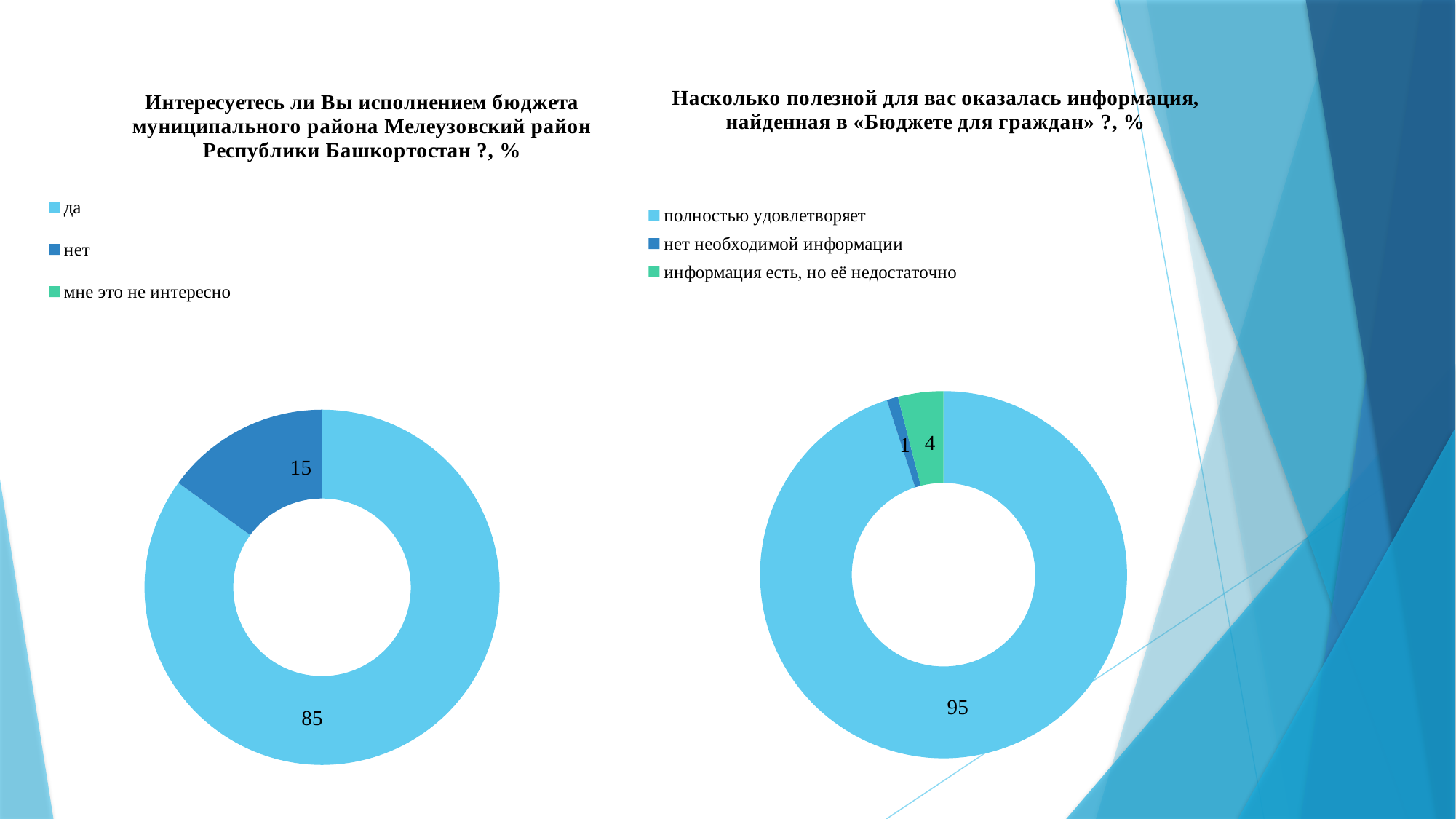
In the right chart, what is the value for "полностью удовлетворяет"? 95 In the right chart, what is the value for "информация есть, но её недостаточно"? 4 How many entries does the legend of the right chart list? 3 In the left chart, what is the value for "нет"? 15 In the left chart, what is the value for "да"? 85 In the right chart, what is the value for "нет необходимой информации"? 1 In the right chart, which category has the smallest slice? нет необходимой информации In the left chart, which category has the largest slice? да In the right chart, which is larger: "информация есть, но её недостаточно" or "нет необходимой информации"? информация есть, но её недостаточно What type of chart is used on the left side of the slide? Doughnut chart In the right chart, what colour is the slice for "информация есть, но её недостаточно"? Green In the left chart, what is the difference between the values for "да" and "нет"? 70